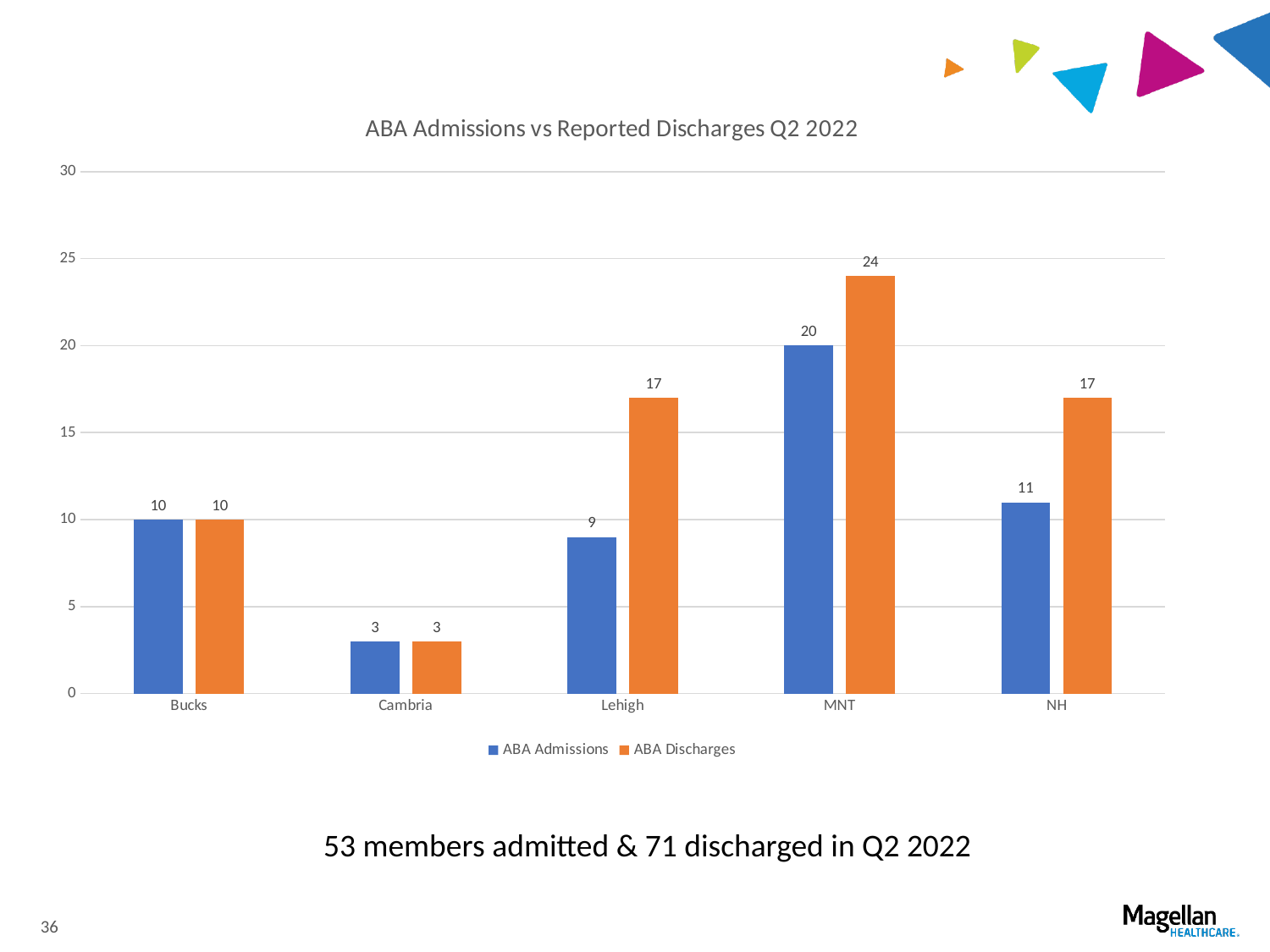
Which is larger for NH: ABA Admissions or ABA Discharges? ABA Discharges What is the value of ABA Admissions for MNT? 20 Which category has the lowest ABA Admissions value? Cambria What is the value of ABA Admissions for NH? 11 What is the difference between ABA Discharges for MNT and ABA Discharges for NH? 7 What is the difference between ABA Discharges and ABA Admissions for Lehigh? 8 What kind of chart is shown on the slide? Bar chart Which category has the highest ABA Discharges value? MNT What is the title of the chart? ABA Admissions vs Reported Discharges Q2 2022 How many categories are shown on the x axis? 5 What is the value of ABA Discharges for Lehigh? 17 How many series does the legend list? 2